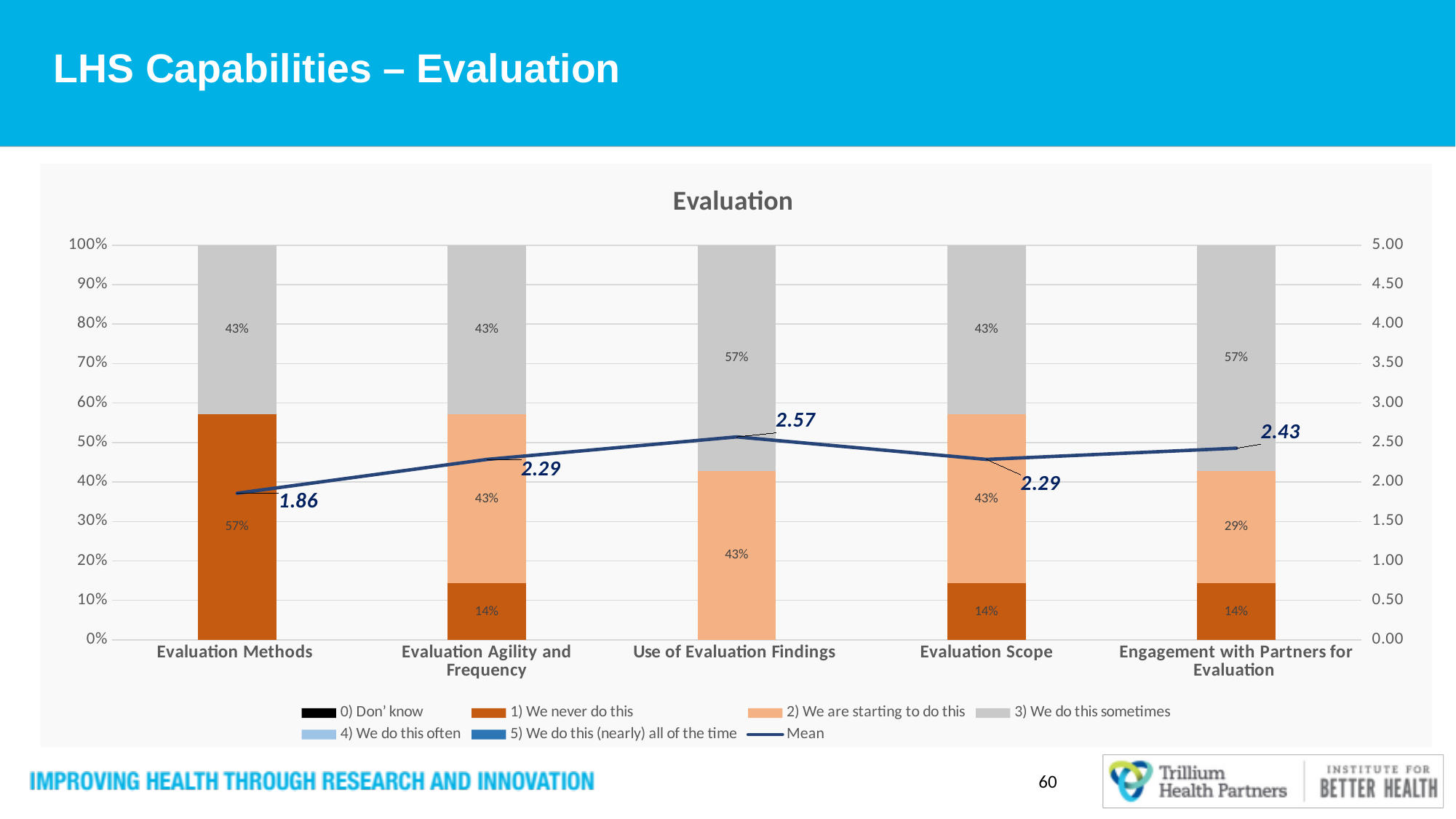
Which is larger: the Mean for Engagement with Partners for Evaluation or the Mean for Evaluation Scope? Engagement with Partners for Evaluation What percentage of respondents chose "3) We do this sometimes" for Engagement with Partners for Evaluation? 57% What kind of chart is this? Stacked bar chart with a line What percentage of respondents chose "1) We never do this" for Evaluation Methods? 57% How many entries does the legend list? 7 What is the Mean value for Evaluation Methods? 1.86 What is the Mean value for Use of Evaluation Findings? 2.57 Which category has the highest Mean value? Use of Evaluation Findings Which category has the lowest Mean value? Evaluation Methods How many categories are shown on the x axis? 5 What percentage of respondents chose "2) We are starting to do this" for Engagement with Partners for Evaluation? 29% What is the difference between the Mean for Use of Evaluation Findings and the Mean for Evaluation Methods? 0.71